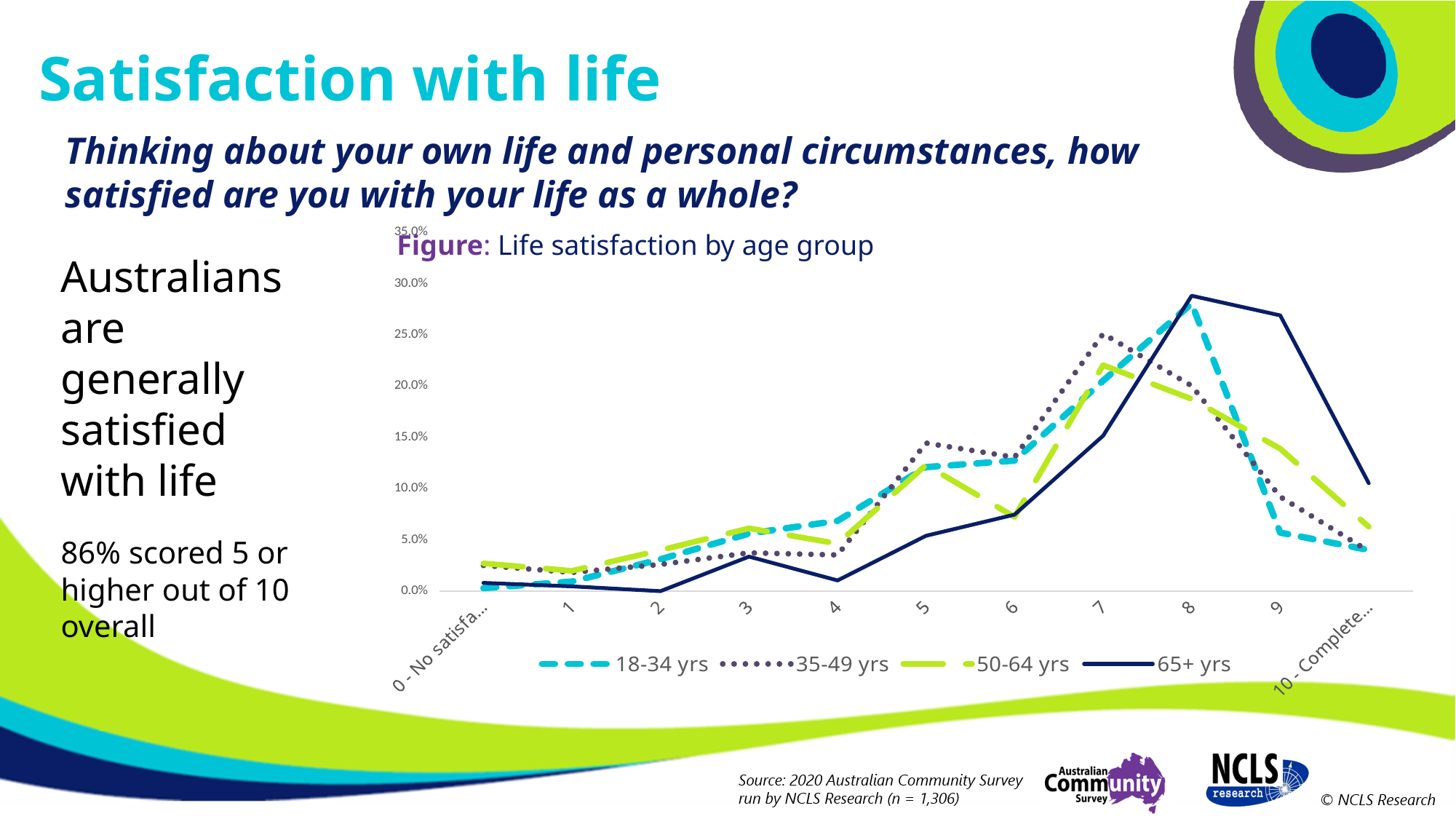
How many series does the legend list? 4 What kind of chart is shown on the slide? line chart Is the value for 65+ yrs at score 9 greater or less than 25.0%? greater Which age group is shown with a solid dark blue line? 65+ yrs How many satisfaction score categories are plotted along the x axis? 11 At which satisfaction score does the 65+ yrs series reach its highest value? 8 At score 9, which series has the larger value, 65+ yrs or 18-34 yrs? 65+ yrs Does the 65+ yrs series rise or fall from score 8 to score 10? fall What is the title of the figure? Life satisfaction by age group At which satisfaction score is the 65+ yrs series at its lowest value? 2 Is the value for 18-34 yrs at score 9 greater or less than 10.0%? less At which satisfaction score does the 35-49 yrs series reach its highest value? 7